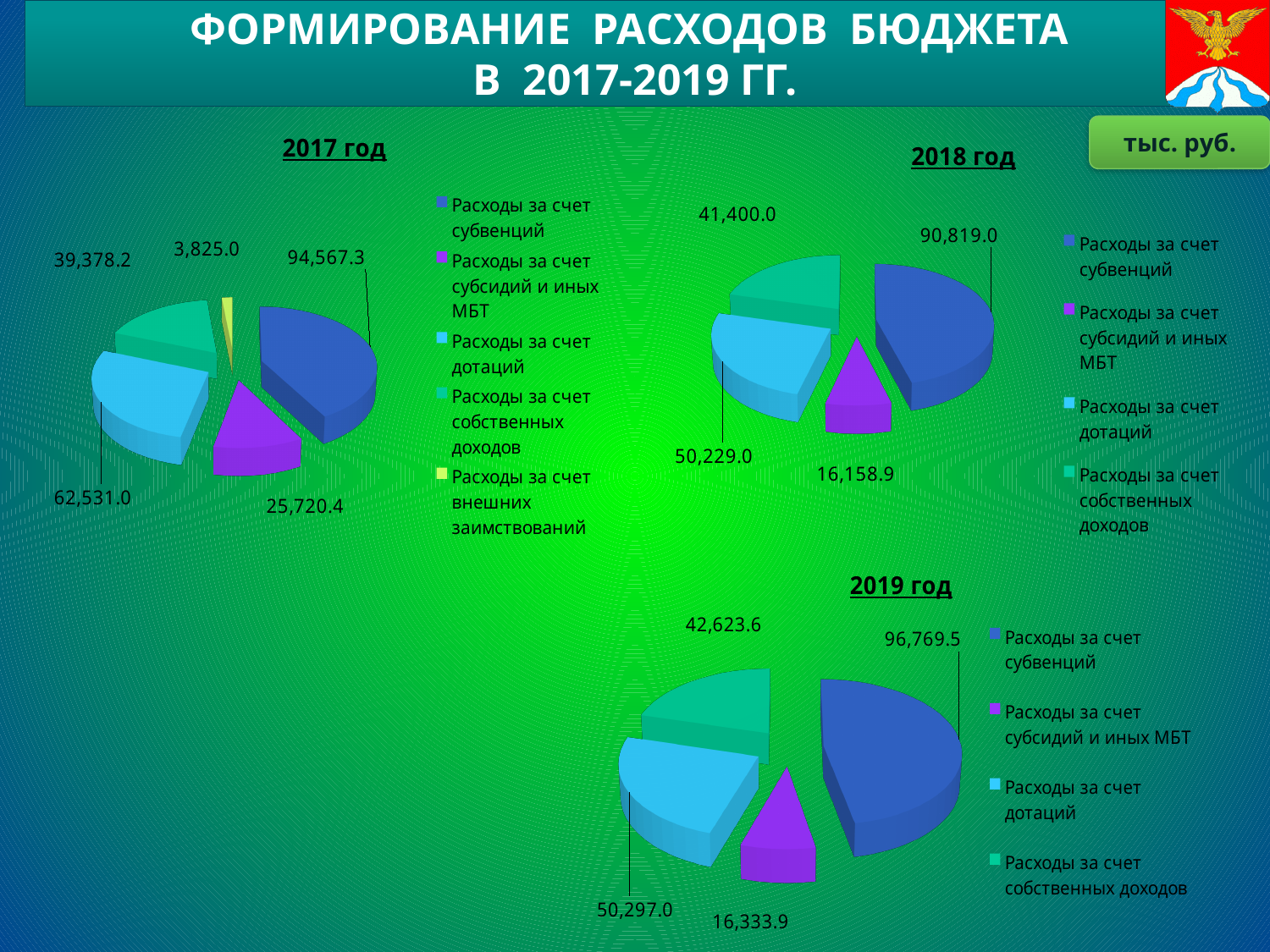
In the 2017 год pie chart, what is the value for Расходы за счет субвенций? 94,567.3 In the 2018 год pie chart, which is larger: Расходы за счет дотаций or Расходы за счет собственных доходов? Расходы за счет дотаций In the 2017 год pie chart, what is the difference between Расходы за счет субвенций and Расходы за счет дотаций? 32,036.3 How many categories does the legend of the 2017 год pie chart list? 5 In the 2019 год pie chart, which category has the largest value? Расходы за счет субвенций In the 2017 год pie chart, which category has the smallest value? Расходы за счет внешних заимствований What type of chart is used for 2019 год? Pie chart How many slices does the 2018 год pie chart have? 4 In the 2018 год pie chart, what is the value for Расходы за счет дотаций? 50,229.0 In the 2017 год pie chart, what is the value for Расходы за счет внешних заимствований? 3,825.0 In the 2019 год pie chart, what is the value for Расходы за счет собственных доходов? 42,623.6 In the 2019 год pie chart, what is the difference between Расходы за счет субвенций and Расходы за счет субсидий и иных МБТ? 80,435.6